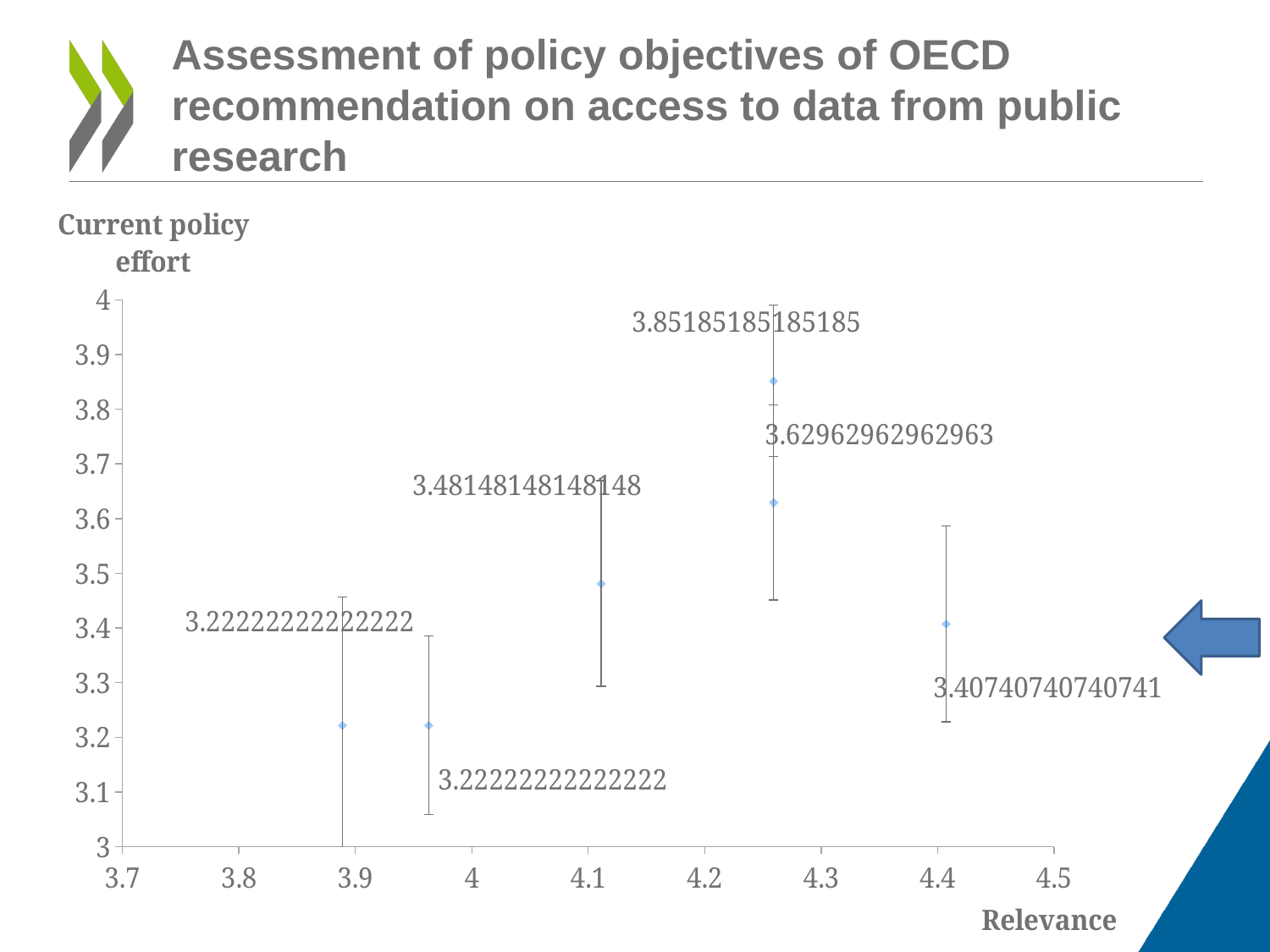
How many points on the chart are labelled 3.22222222222222? 2 How many data points are plotted on the chart? 6 What is the difference between the highest labelled value (3.85185185185185) and the lowest labelled value (3.22222222222222)? 0.62962962962963 What is the title of the vertical axis? Current policy effort What is the title of the horizontal axis? Relevance What is the lowest Current policy effort value labelled on the chart? 3.22222222222222 What is the Current policy effort value of the point labelled just below the highest point, at Relevance around 4.26? 3.62962962962963 Is the Current policy effort value of the point at Relevance around 4.1 greater or less than 3.4? greater What is the highest Current policy effort value labelled on the chart? 3.85185185185185 Is the Current policy effort value of the point with the highest Relevance (around 4.4) greater or less than 3.5? less What kind of chart is shown on the slide? scatter chart Which is larger: the point labelled 3.48148148148148 or the point labelled 3.40740740740741? 3.48148148148148